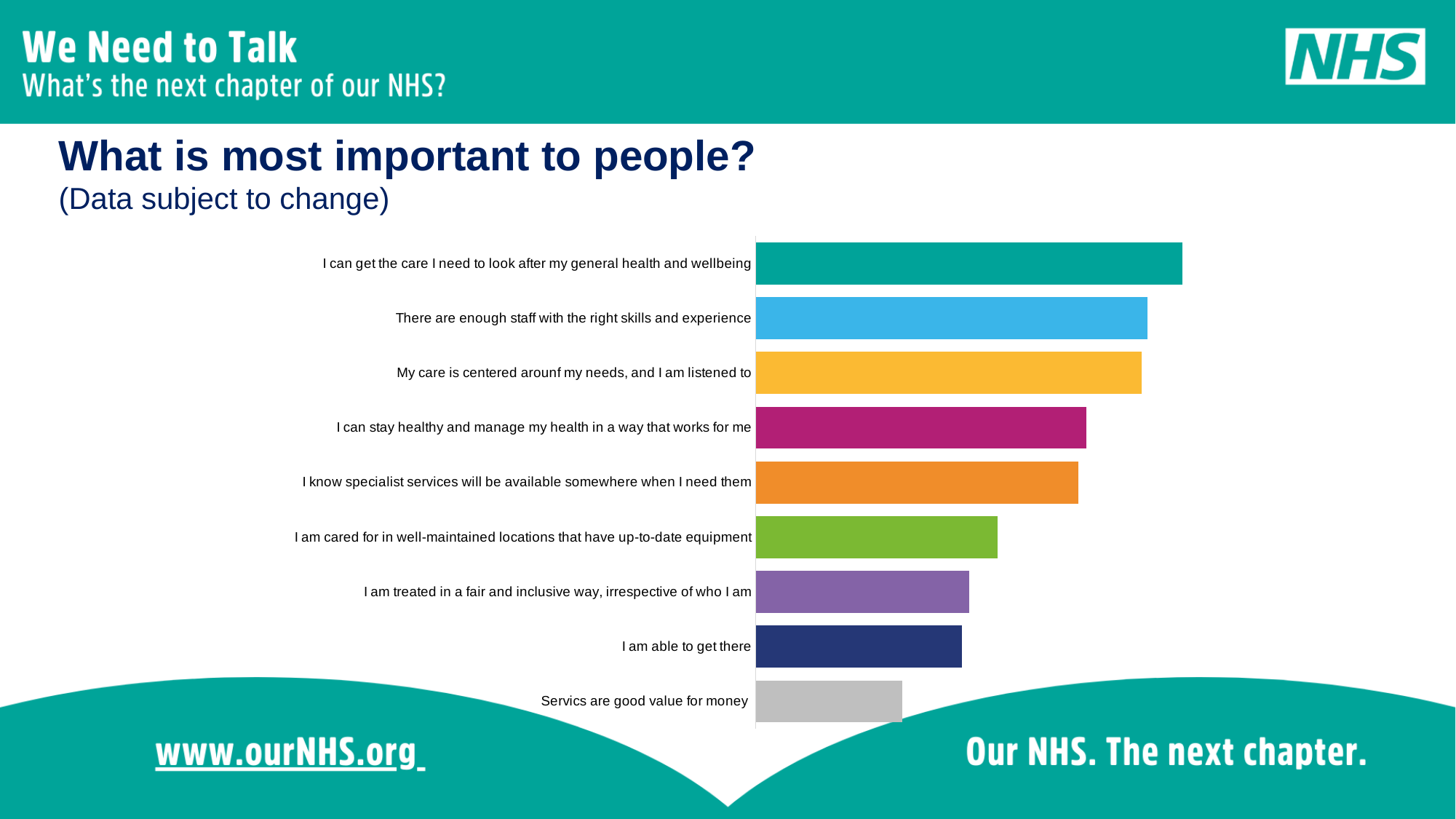
How many categories (bars) does the chart show? 9 Which has the larger value: 'I am able to get there' or 'Servics are good value for money'? I am able to get there Which category has the highest value in the chart? I can get the care I need to look after my general health and wellbeing What colour is the bar for 'Servics are good value for money'? grey Which has the larger value: 'I can get the care I need to look after my general health and wellbeing' or 'Servics are good value for money'? I can get the care I need to look after my general health and wellbeing Which has the larger value: 'I know specialist services will be available somewhere when I need them' or 'I am able to get there'? I know specialist services will be available somewhere when I need them Do the bar values increase or decrease going from the top category to the bottom category? decrease What is the title of the slide containing the chart? What is most important to people? Which category has the lowest value in the chart? Servics are good value for money What kind of chart is shown on the slide? bar chart